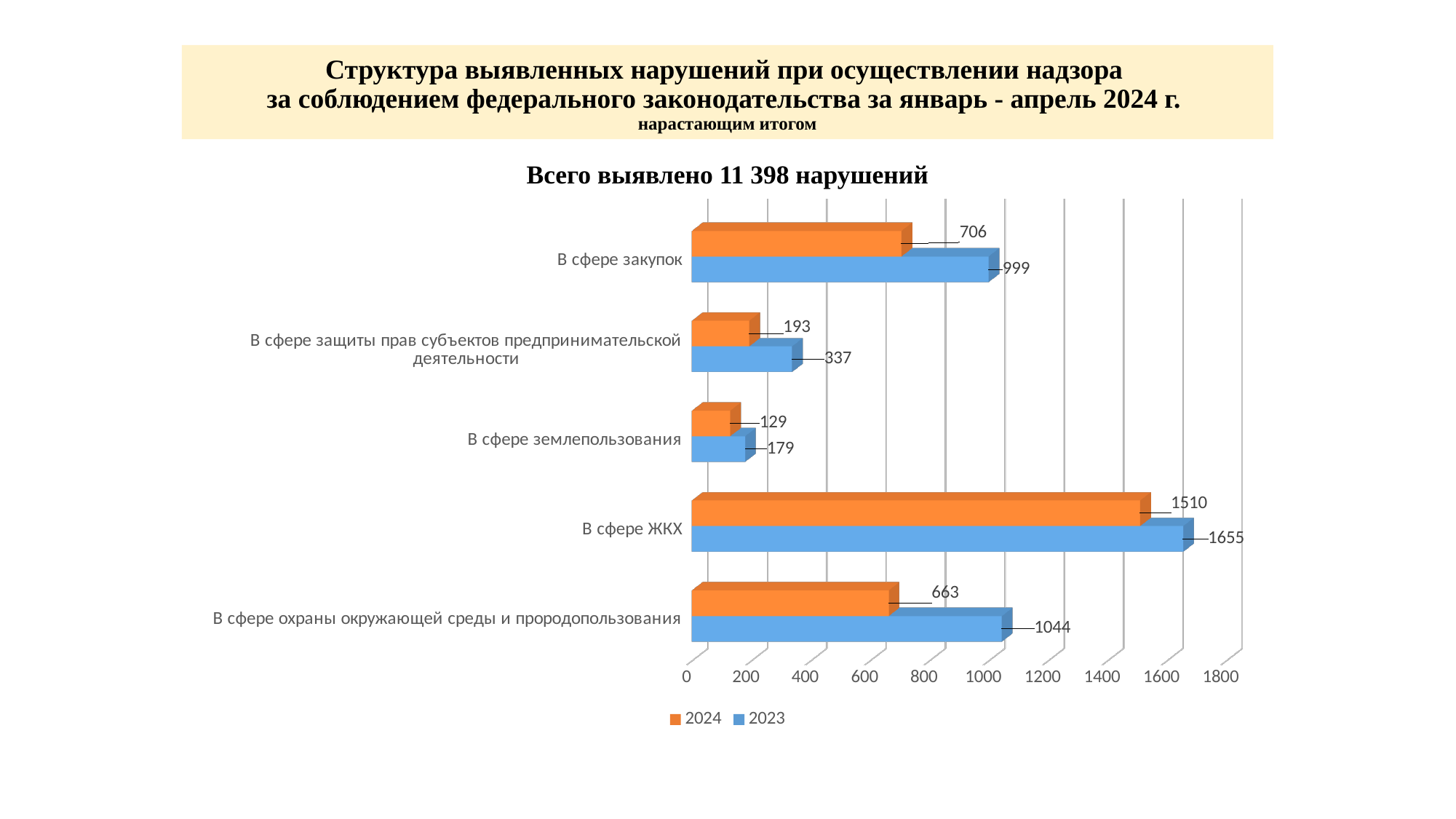
What is the difference between the 2023 and 2024 values for В сфере закупок? 293 Which category has the highest 2024 value? В сфере ЖКХ What is the 2024 value for В сфере охраны окружающей среды и прородопользования? 663 Which category has the lowest 2023 value? В сфере землепользования What is the 2024 value for В сфере закупок? 706 Which is larger for В сфере ЖКХ: the 2024 value or the 2023 value? 2023 What is the 2023 value for В сфере землепользования? 179 How many categories are shown on the chart? 5 What kind of chart is shown on the slide? Bar chart How many series does the legend list? 2 What is the 2023 value for В сфере ЖКХ? 1655 What is the difference between the 2023 and 2024 values for В сфере защиты прав субъектов предпринимательской деятельности? 144